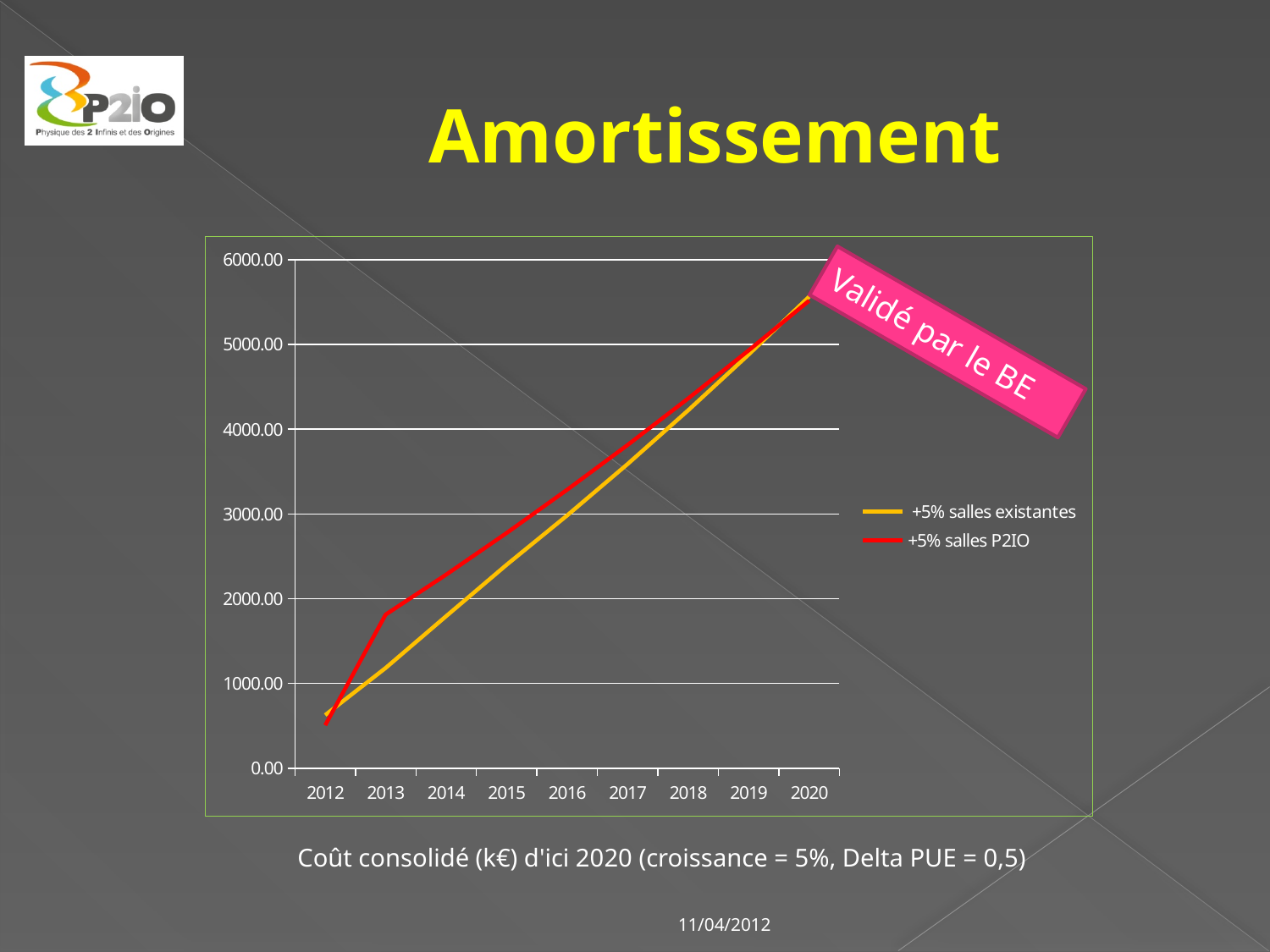
Do the values for '+5% salles existantes' rise or fall from 2012 to 2020? rise Do the values for '+5% salles P2IO' rise or fall from 2012 to 2020? rise In 2013, which series has the larger value, '+5% salles existantes' or '+5% salles P2IO'? +5% salles P2IO Is the value for '+5% salles P2IO' in 2020 greater or less than 5000.00? greater Is the value for '+5% salles existantes' in 2020 greater or less than 6000.00? less How many years are shown along the x axis? 9 How many series does the legend list? 2 What kind of chart is shown on the slide? line chart Is the value for '+5% salles existantes' in 2012 greater or less than 1000.00? less Which colour is used for the '+5% salles P2IO' series? red What is the title of the slide containing the chart? Amortissement